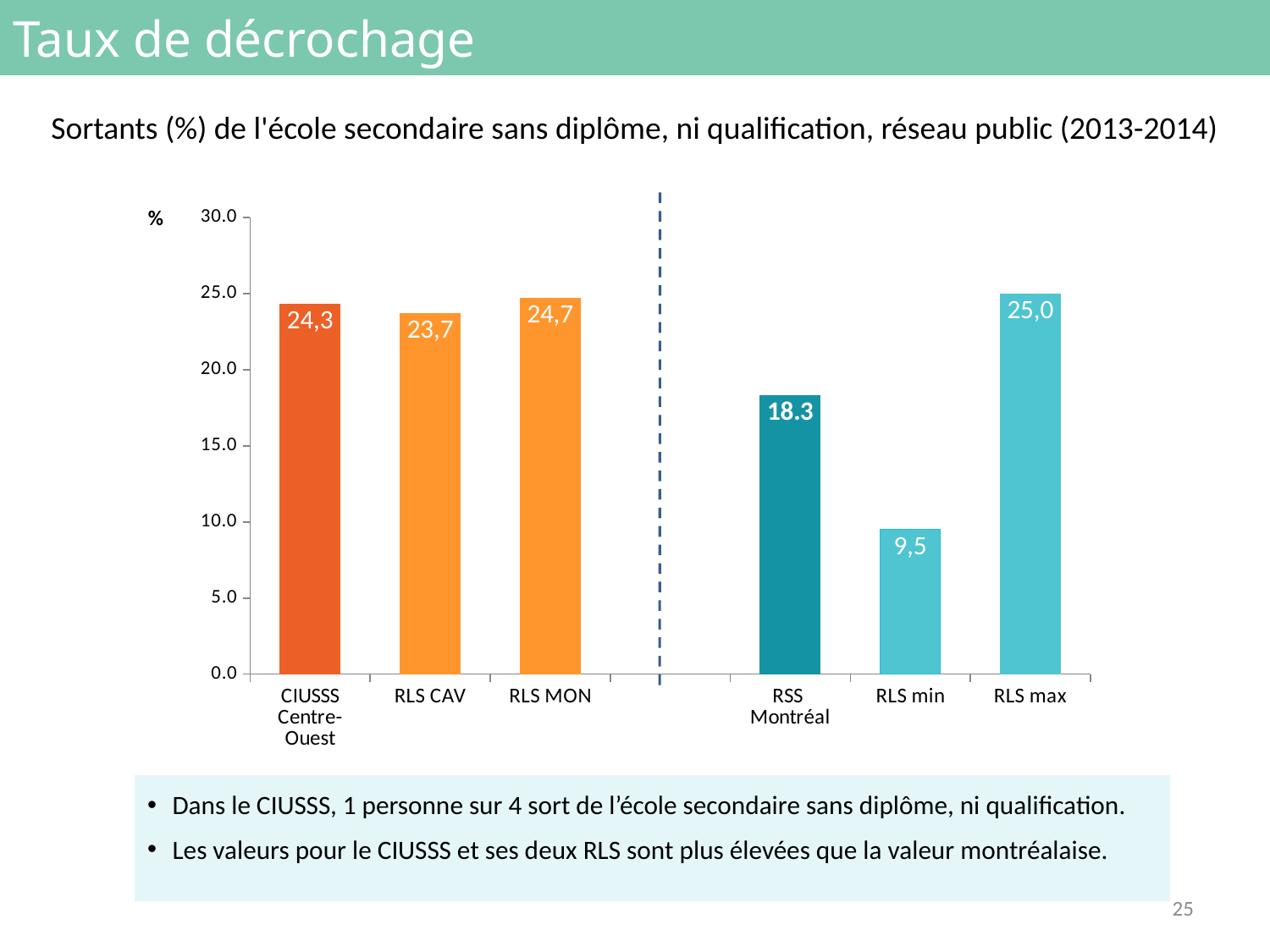
Is the value for RSS Montréal greater or less than 20.0? less What is the value for RSS Montréal? 18.3 What kind of chart is shown on the slide? bar chart What is the difference between the values for RLS MON and RLS CAV? 1,0 What is the value for CIUSSS Centre-Ouest? 24,3 Which category has the lowest value? RLS min What is the value for RLS CAV? 23,7 Which is larger, the value for RLS CAV or the value for RSS Montréal? RLS CAV Which category has the highest value? RLS max What is the difference between the values for RLS max and RLS min? 15,5 What is the value for RLS min? 9,5 How many categories are shown on the x axis of the chart? 6